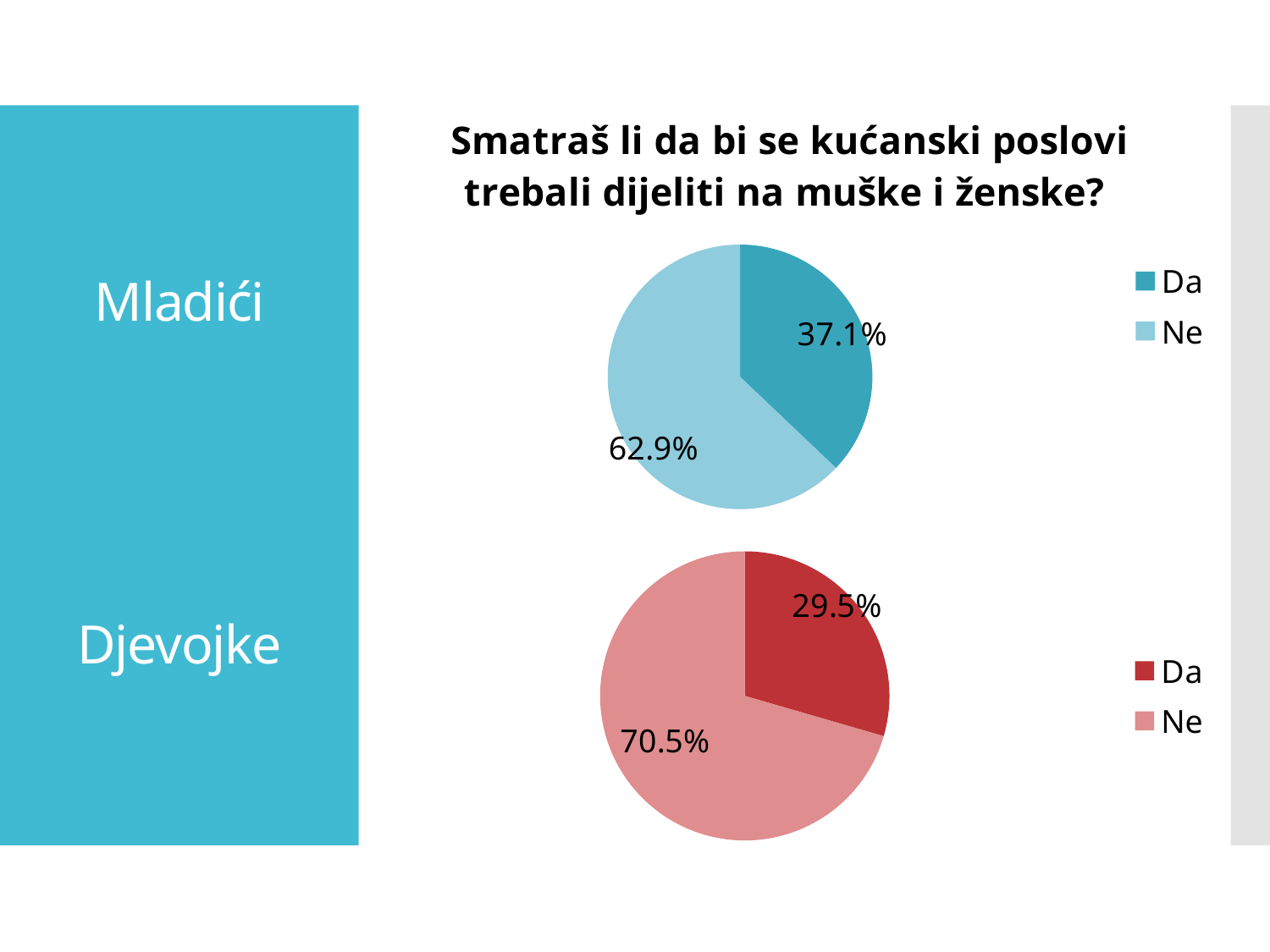
In the bottom pie chart (Djevojke), what percentage answered "Da"? 29.5% In the bottom pie chart (Djevojke), what is the difference between the "Ne" and "Da" shares? 41.0% In the bottom pie chart (Djevojke), what percentage answered "Ne"? 70.5% In the top pie chart (Mladići), which answer has the larger share? Ne In the top pie chart (Mladići), what percentage answered "Ne"? 62.9% What type of chart is used for the Mladići data at the top of the slide? Pie chart In the top pie chart (Mladići), what percentage answered "Da"? 37.1% How many slices does the bottom pie chart (Djevojke) have? 2 In the top pie chart (Mladići), what is the difference between the "Ne" and "Da" shares? 25.8% Which group has the larger "Da" share, Mladići (top chart) or Djevojke (bottom chart)? Mladići In the bottom pie chart (Djevojke), which answer has the smaller share? Da How many entries does the legend of the top pie chart (Mladići) list? 2